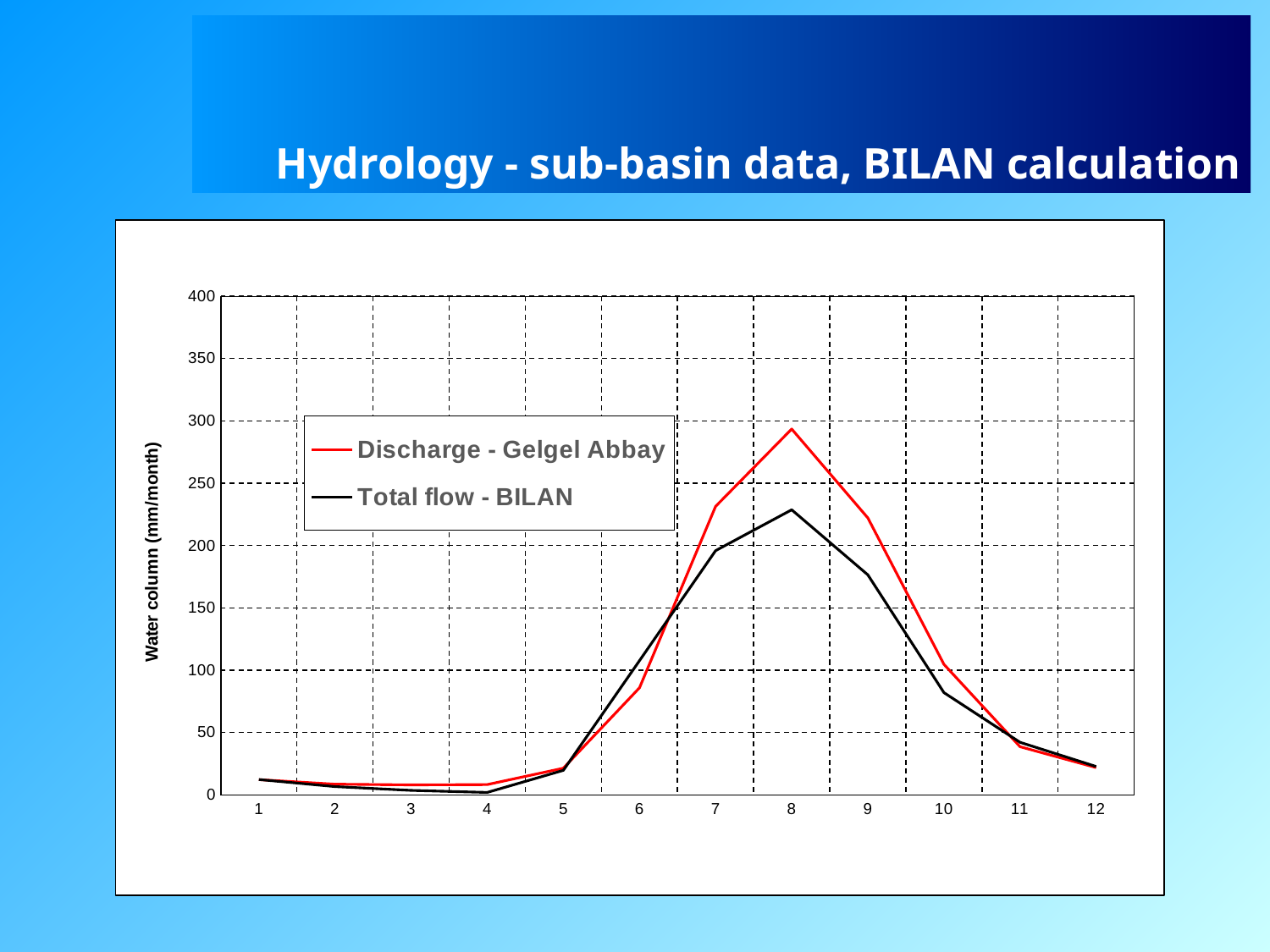
Is the value for Total flow - BILAN at 8 greater or less than 250? less Do the values of the Discharge - Gelgel Abbay series rise or fall from 8 to 12 along the x axis? fall Is the value for Discharge - Gelgel Abbay at 8 greater or less than 250? greater At which x-axis value does the Total flow - BILAN series reach its highest point? 8 At which x-axis value does the Discharge - Gelgel Abbay series reach its highest point? 8 How many series does the legend list? 2 Is the value for Discharge - Gelgel Abbay at 7 greater or less than 200? greater What is the label of the y axis? Water column (mm/month) How many points are plotted along the x axis for each series? 12 At x-axis value 8, which series has the higher value? Discharge - Gelgel Abbay What kind of chart is shown on the slide? line chart